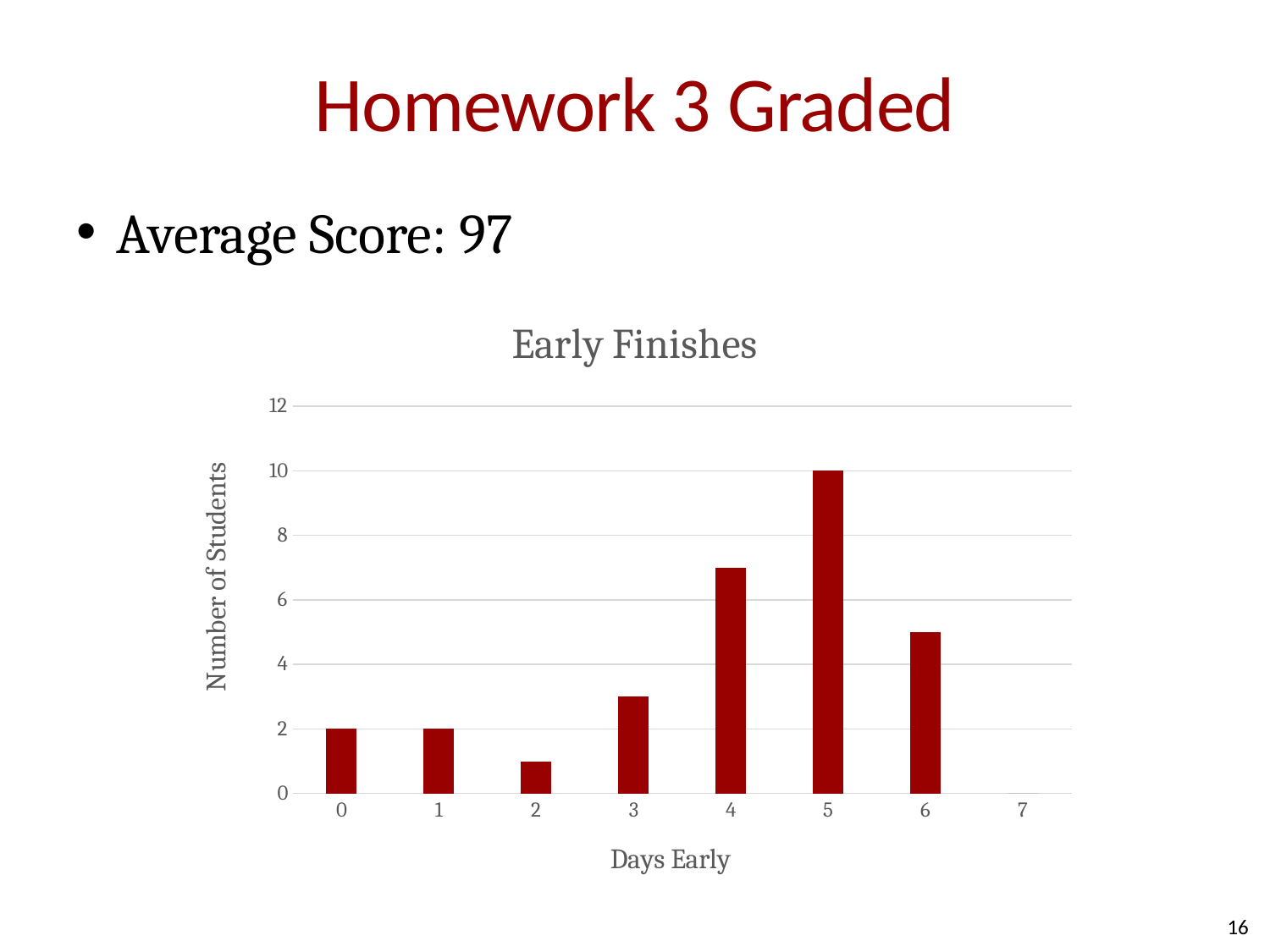
What is the title of the chart? Early Finishes How many more students finished 5 days early than 0 days early? 8 Is the number of students who finished 4 days early greater or less than 6? greater Is the number of students who finished 6 days early greater or less than 6? less What is the label of the vertical axis of the chart? Number of Students Which number of days early has the highest number of students? 5 Which has more students: 4 days early or 6 days early? 4 days early How many students finished 5 days early? 10 What type of chart is shown on the slide? bar chart How many students finished 1 day early? 2 Among 0 through 6 days early, which has the fewest students? 2 How many students finished 0 days early? 2